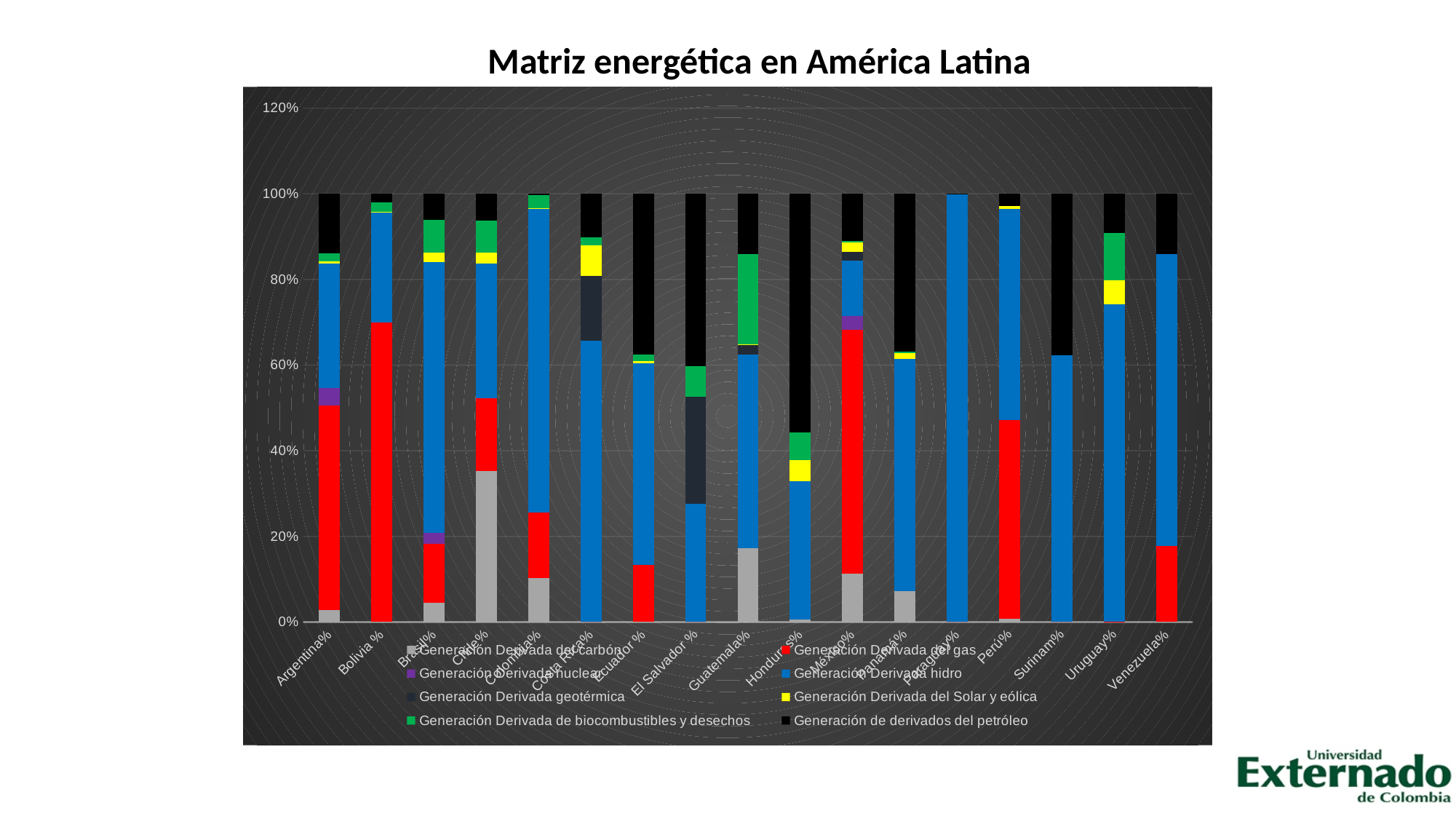
Is the share of 'Generación Derivada del carbón' for Chile greater or less than 20%? greater How many countries (categories) are shown on the x axis? 17 Which has a larger share of 'Generación Derivada del carbón', Chile or Colombia? Chile Is the share of 'Generación Derivada del gas' for Bolivia greater or less than 60%? greater Is the share of 'Generación Derivada hidro' for Paraguay greater or less than 80%? greater What kind of chart is shown on the slide? Stacked bar chart Which country has the largest share of 'Generación Derivada del gas'? Bolivia Which colour represents 'Generación Derivada hidro' in the legend? Blue Which country has the largest share of 'Generación Derivada hidro'? Paraguay What is the title of the chart? Matriz energética en América Latina How many series does the legend list? 8